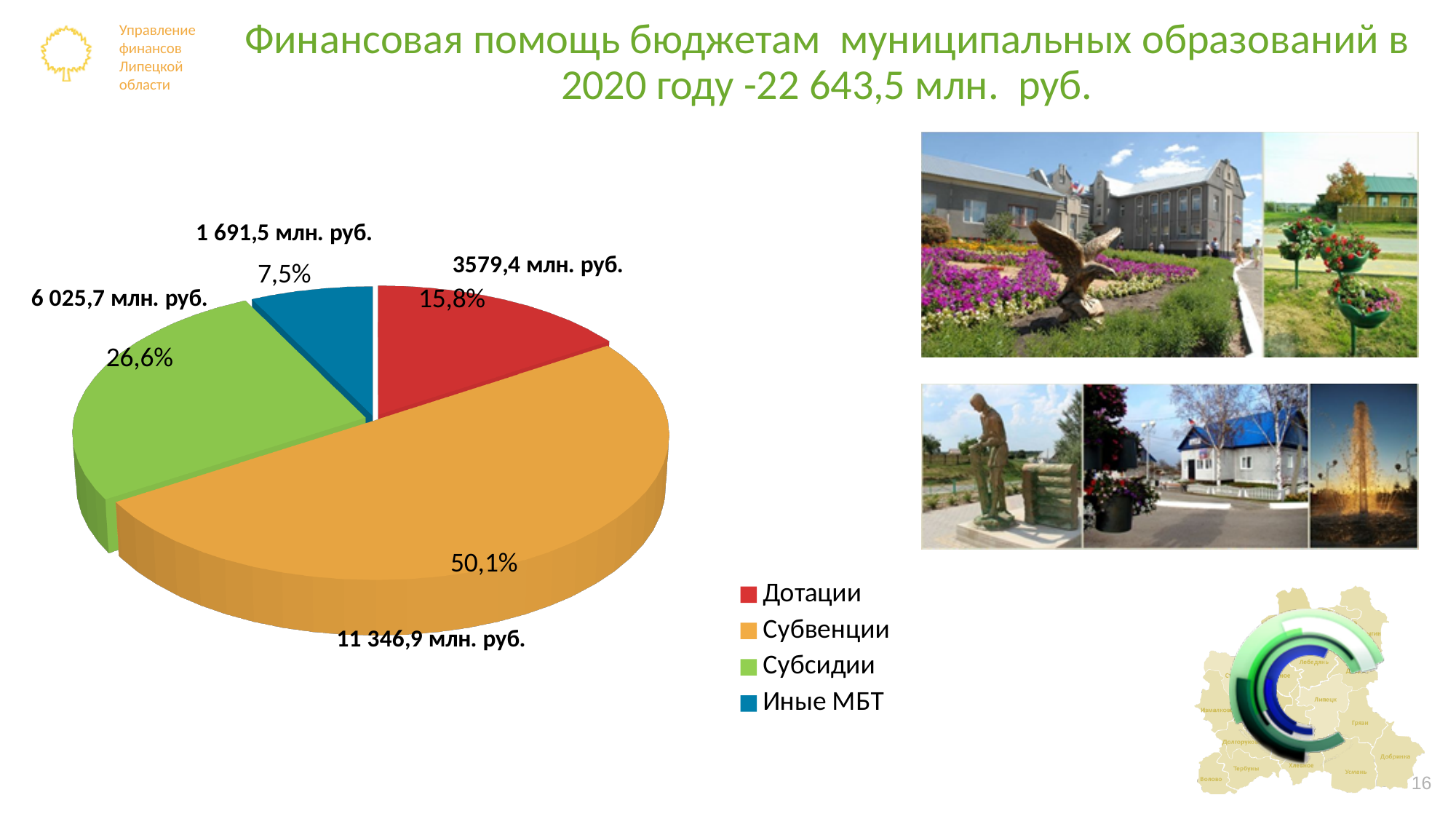
What is the value for Иные МБТ? 1 691,5 млн. руб. What share of the pie does Иные МБТ take? 7,5% Which category has the largest slice? Субвенции Which is larger, Субсидии or Дотации? Субсидии What is the value for Субсидии? 6 025,7 млн. руб. What is the value for Дотации? 3579,4 млн. руб. What share of the pie does Субвенции take? 50,1% Which category has the smallest slice? Иные МБТ How many series does the legend list? 4 Which colour represents Субсидии in the pie chart? Green What kind of chart is shown on the slide? Pie chart What is the value for Субвенции? 11 346,9 млн. руб.